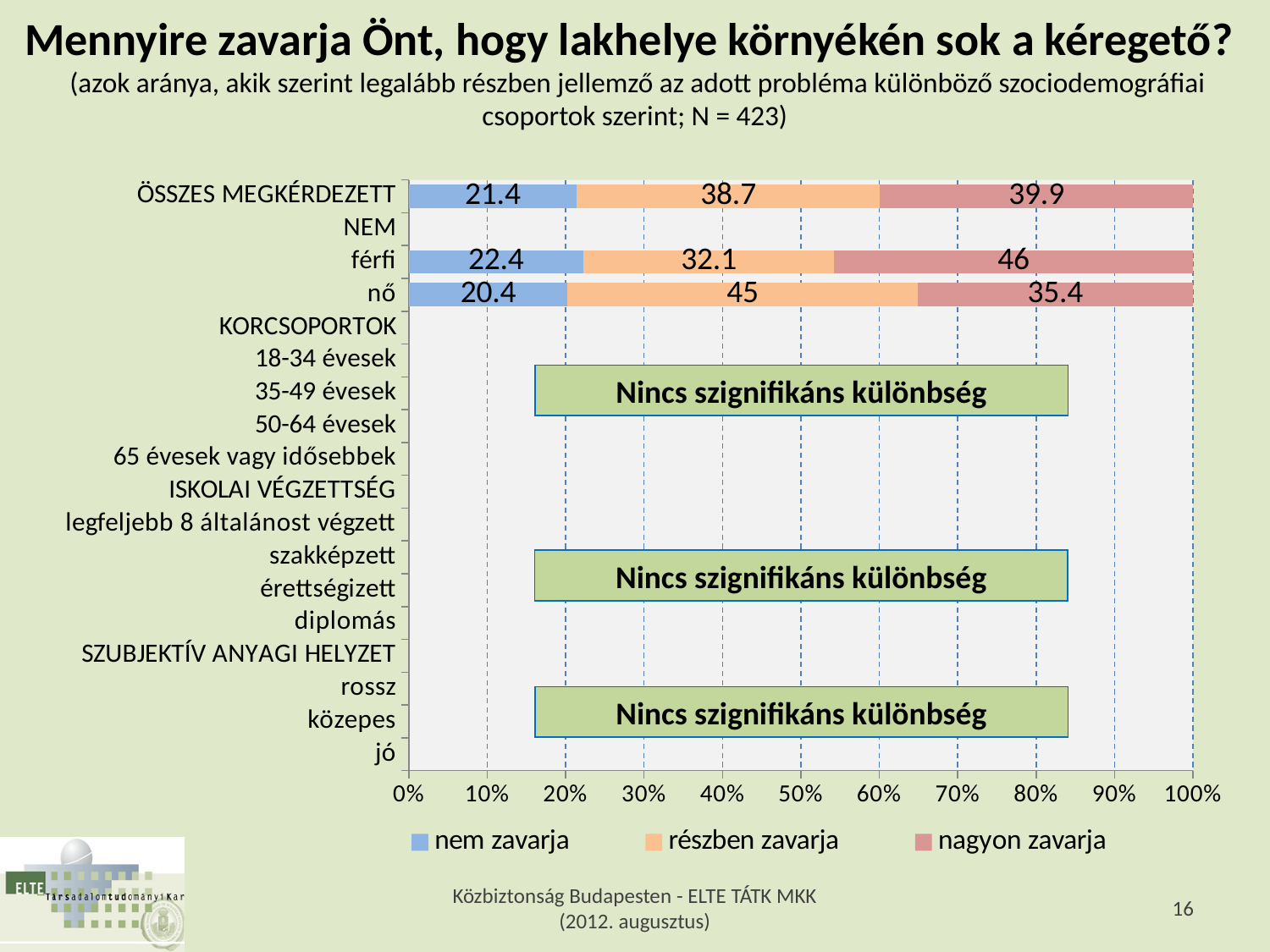
How many series does the legend list? 3 What text appears in the green boxes placed over the KORCSOPORTOK, ISKOLAI VÉGZETTSÉG and SZUBJEKTÍV ANYAGI HELYZET groups? Nincs szignifikáns különbség What is the difference between the "részben zavarja" values for nő and férfi? 12.9 What is the total of the stacked bar for ÖSSZES MEGKÉRDEZETT? 100 What is the value of "nem zavarja" for ÖSSZES MEGKÉRDEZETT? 21.4 What is the value of "részben zavarja" for nő? 45 What is the value of "nagyon zavarja" for férfi? 46 Which category has the lowest "nem zavarja" value among the plotted bars? nő Which category has the highest "nagyon zavarja" value among the plotted bars? férfi What kind of chart is shown on the slide? stacked bar chart What is the value of "nagyon zavarja" for nő? 35.4 Which is larger: the "nagyon zavarja" value for férfi or for nő? férfi